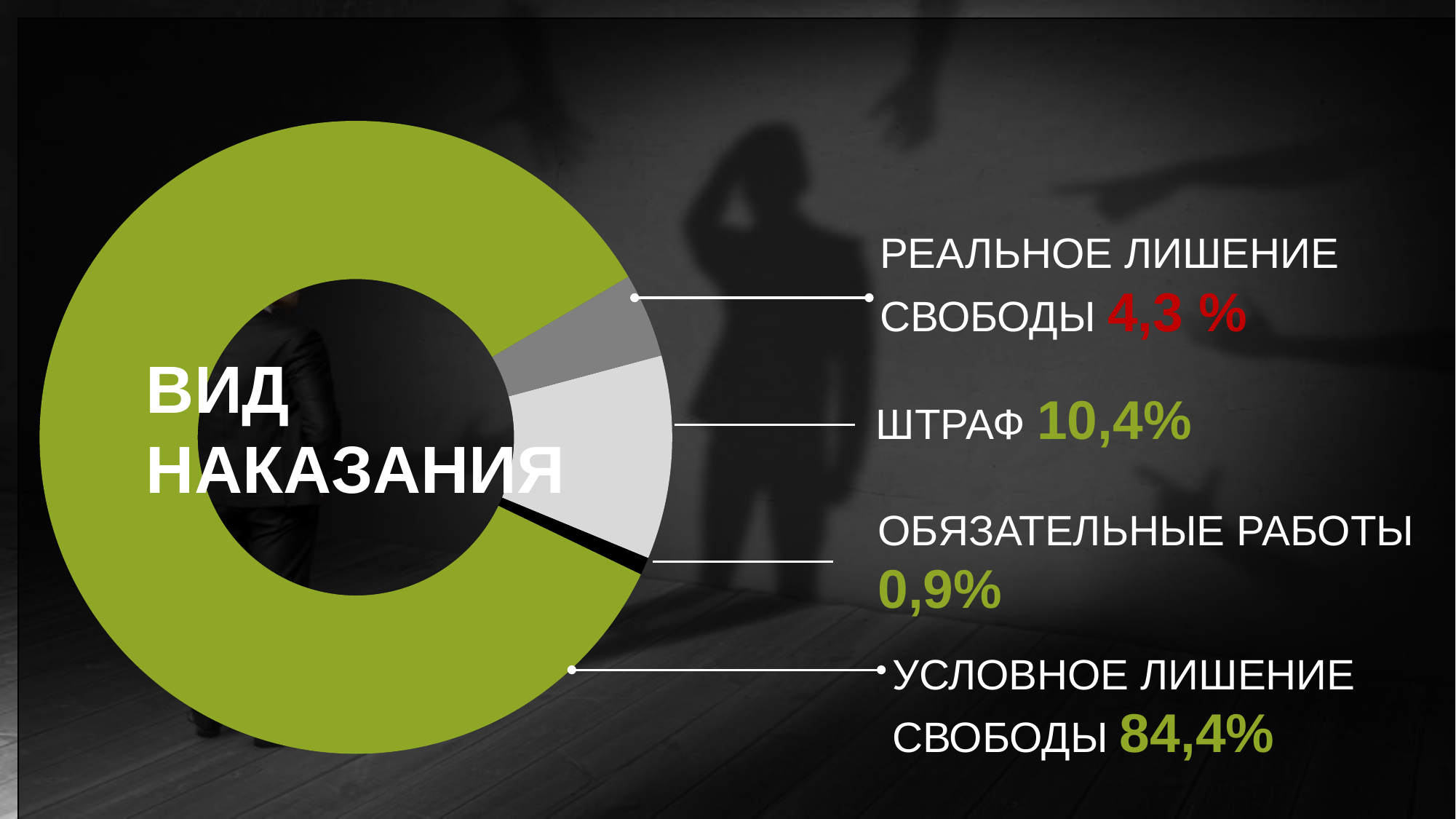
How many categories does the chart show? 4 What share is shown for Обязательные работы? 0,9% What is the title of the chart? ВИД НАКАЗАНИЯ Which category has the largest share? Условное лишение свободы Which category has the smallest share? Обязательные работы Which is larger: Штраф or Реальное лишение свободы? Штраф What share is shown for Реальное лишение свободы? 4,3 % What share is shown for Условное лишение свободы? 84,4% What is the difference between the shares of Штраф and Реальное лишение свободы? 6,1% Which category is shown in green on the chart? Условное лишение свободы What share is shown for Штраф? 10,4% What type of chart is shown on the slide? Pie chart (donut)